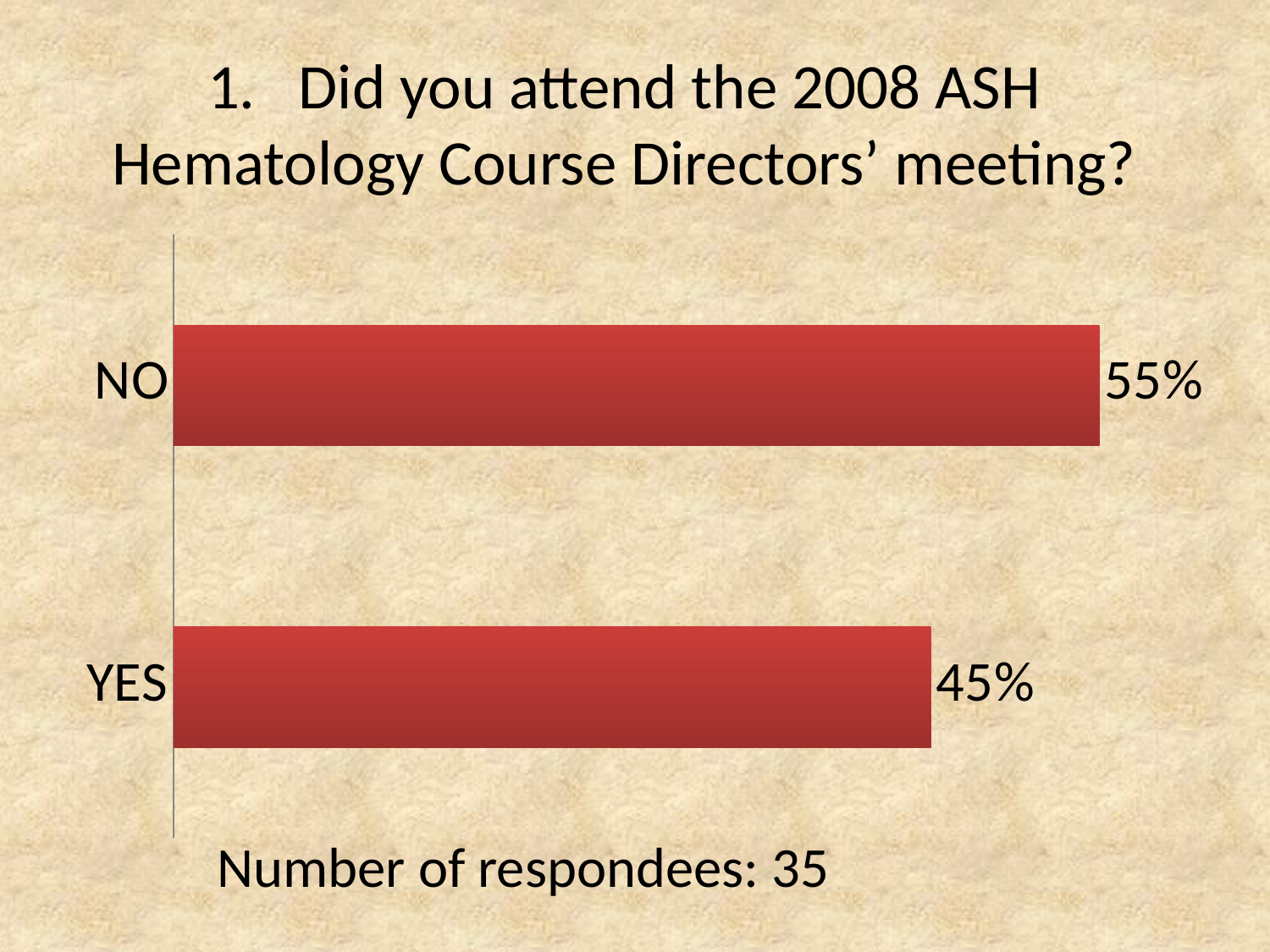
What percentage of respondents answered NO? 55% Which response has the higher percentage, YES or NO? NO What colour are the bars in the chart? red What is the difference in percentage points between the NO and YES responses? 10% How many response categories are shown in the chart? 2 Which response has the lower percentage? YES What percentage of respondents answered YES? 45% What kind of chart is shown on the slide? bar chart Is the value for YES larger or smaller than the value for NO? smaller How many respondees does the slide report? 35 What is the total of the YES and NO percentages? 100%